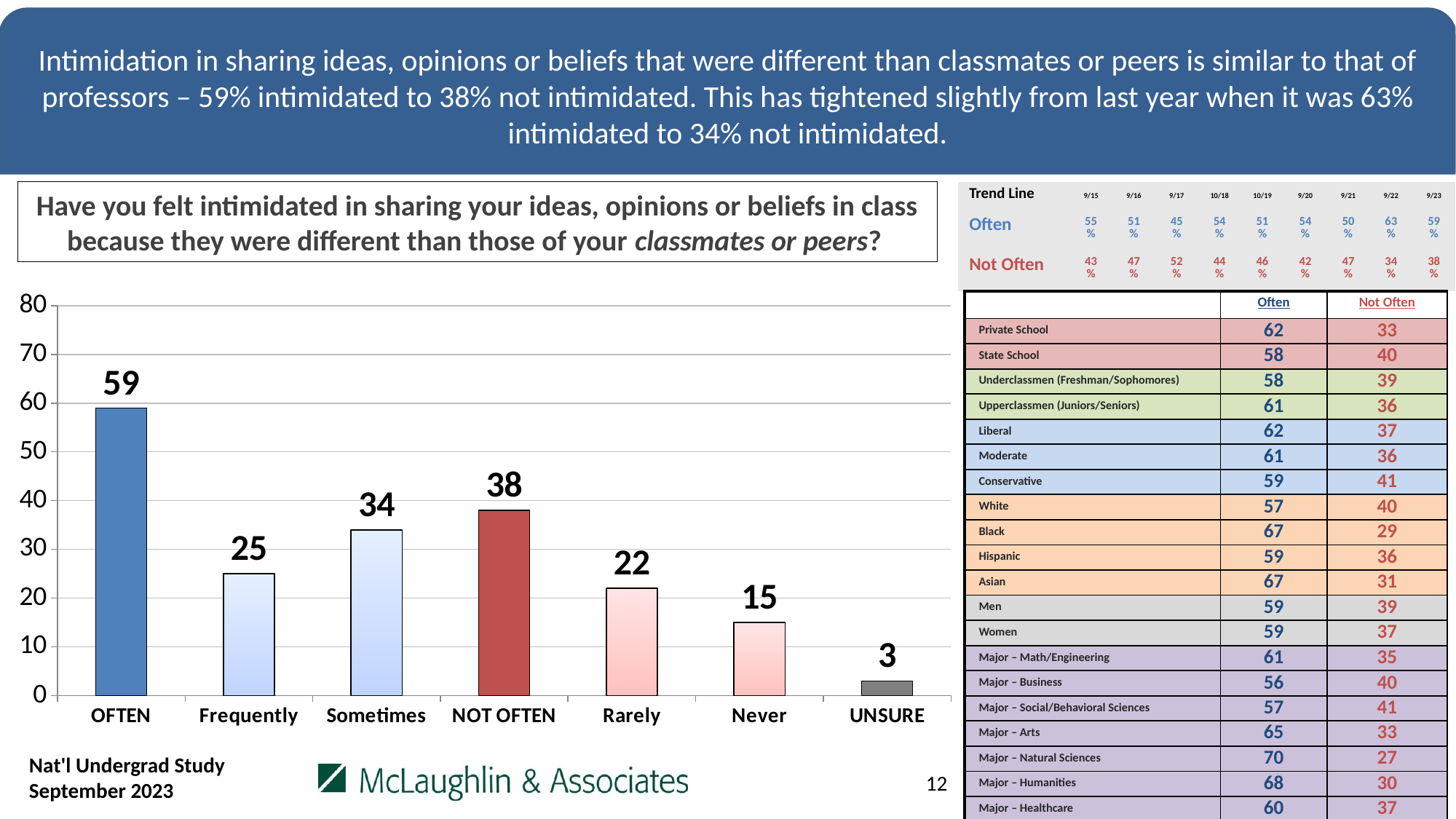
Which category has the highest value in the bar chart? OFTEN What kind of chart is shown on the slide? bar chart What is the value for NOT OFTEN in the bar chart? 38 What is the value for UNSURE in the bar chart? 3 What is the value for OFTEN in the bar chart? 59 Which is larger in the bar chart, Frequently or Rarely? Frequently What is the difference between the values for OFTEN and NOT OFTEN in the bar chart? 21 What is the value for Sometimes in the bar chart? 34 Which category has the lowest value in the bar chart? UNSURE Is the value for Never in the bar chart greater or less than 20? less What is the difference between the values for Sometimes and Frequently in the bar chart? 9 How many categories are shown in the bar chart? 7